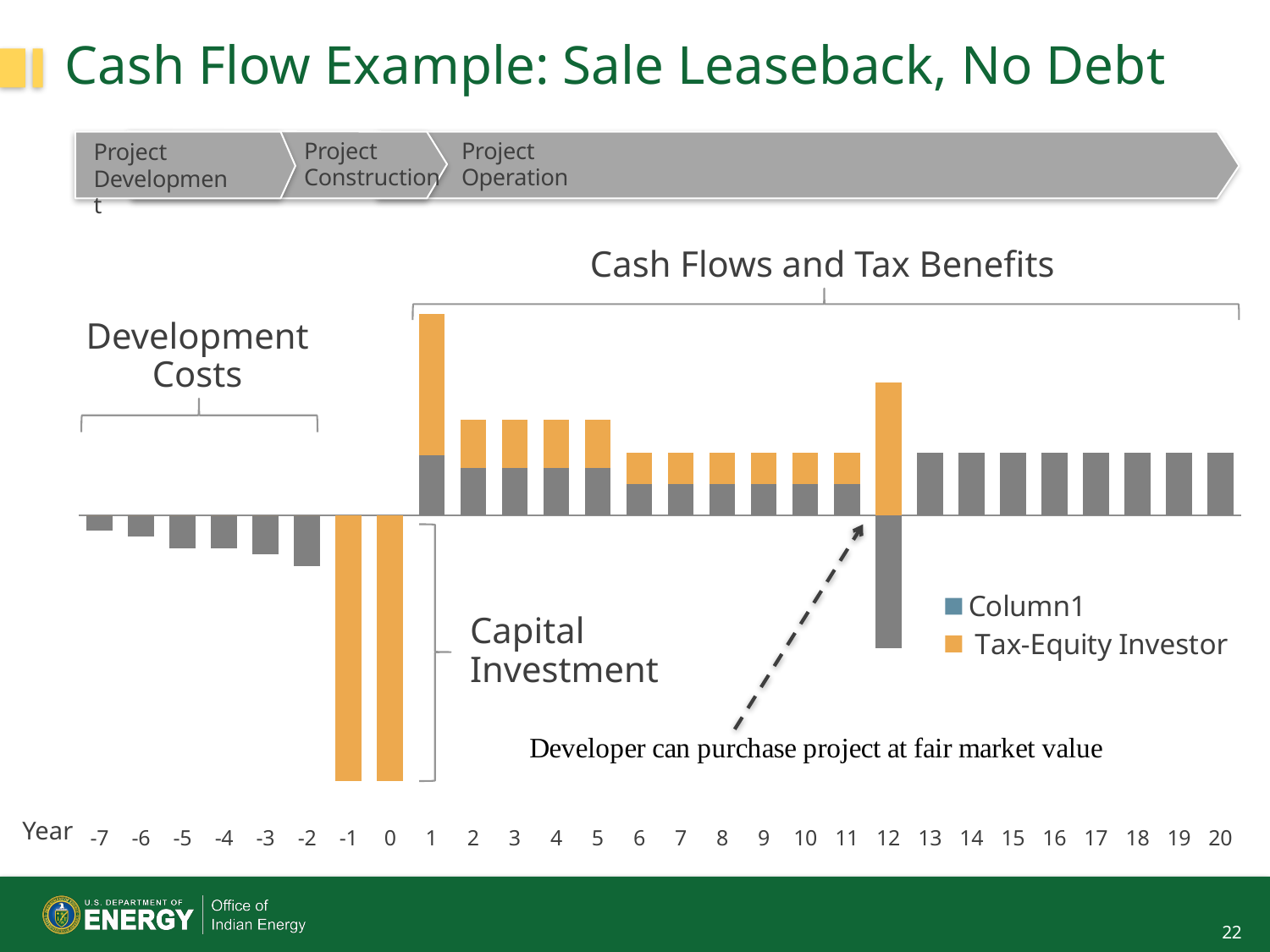
Which year has the largest negative bar in the chart? -1 and 0 (tied) In which year does the Tax-Equity Investor series last appear as a positive bar? 12 How many series does the chart legend list? 2 Which year has the tallest positive stacked bar in the chart? 1 How many year categories are shown along the x axis of the chart? 28 What kind of chart is shown on the slide? bar chart What are the two series named in the chart legend? Column1 and Tax-Equity Investor Do the negative development cost bars get larger or smaller in magnitude from year -7 to year -2? larger What colour represents the Tax-Equity Investor series in the chart? orange What is the last year label on the x axis of the chart? 20 Is the positive bar for year 1 taller or shorter than the positive bar for year 12? taller What is the first year label on the x axis of the chart? -7